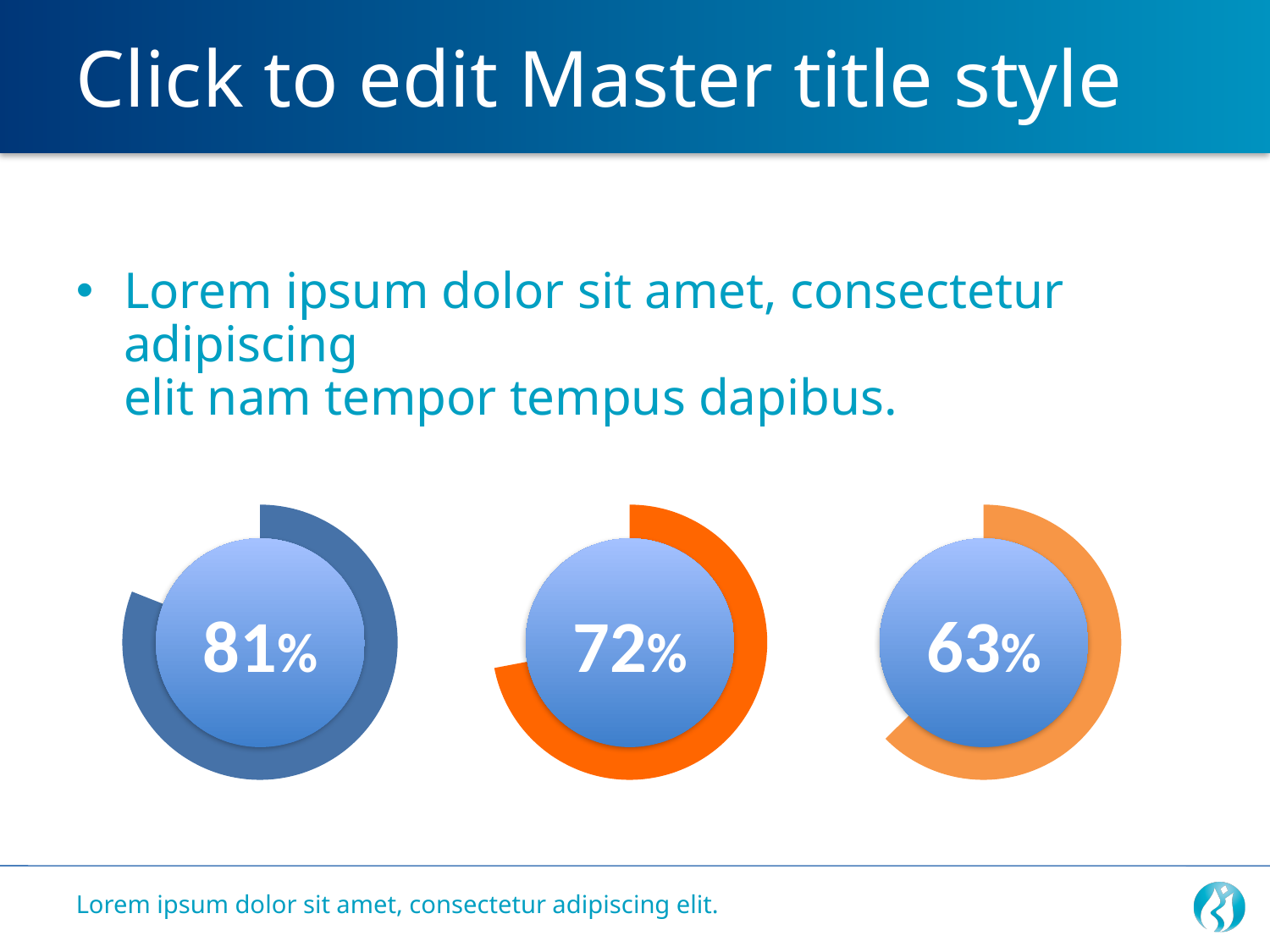
What is the difference between the value in the left chart and the value in the right chart? 18% What colour is the ring around the left circular chart? Blue What colour is the ring around the middle circular chart? Orange How many circular charts are shown on the slide? 3 Which of the three circular charts shows the highest value? The left chart (81%) What is the difference between the value in the left chart and the value in the middle chart? 9% Do the values decrease or increase from the left chart to the right chart? Decrease Which of the three circular charts shows the lowest value? The right chart (63%) Which is larger, the value in the middle chart or the value in the right chart? The middle chart (72%) What value is shown in the right circular chart? 63% What value is shown in the left circular chart? 81% What value is shown in the middle circular chart? 72%